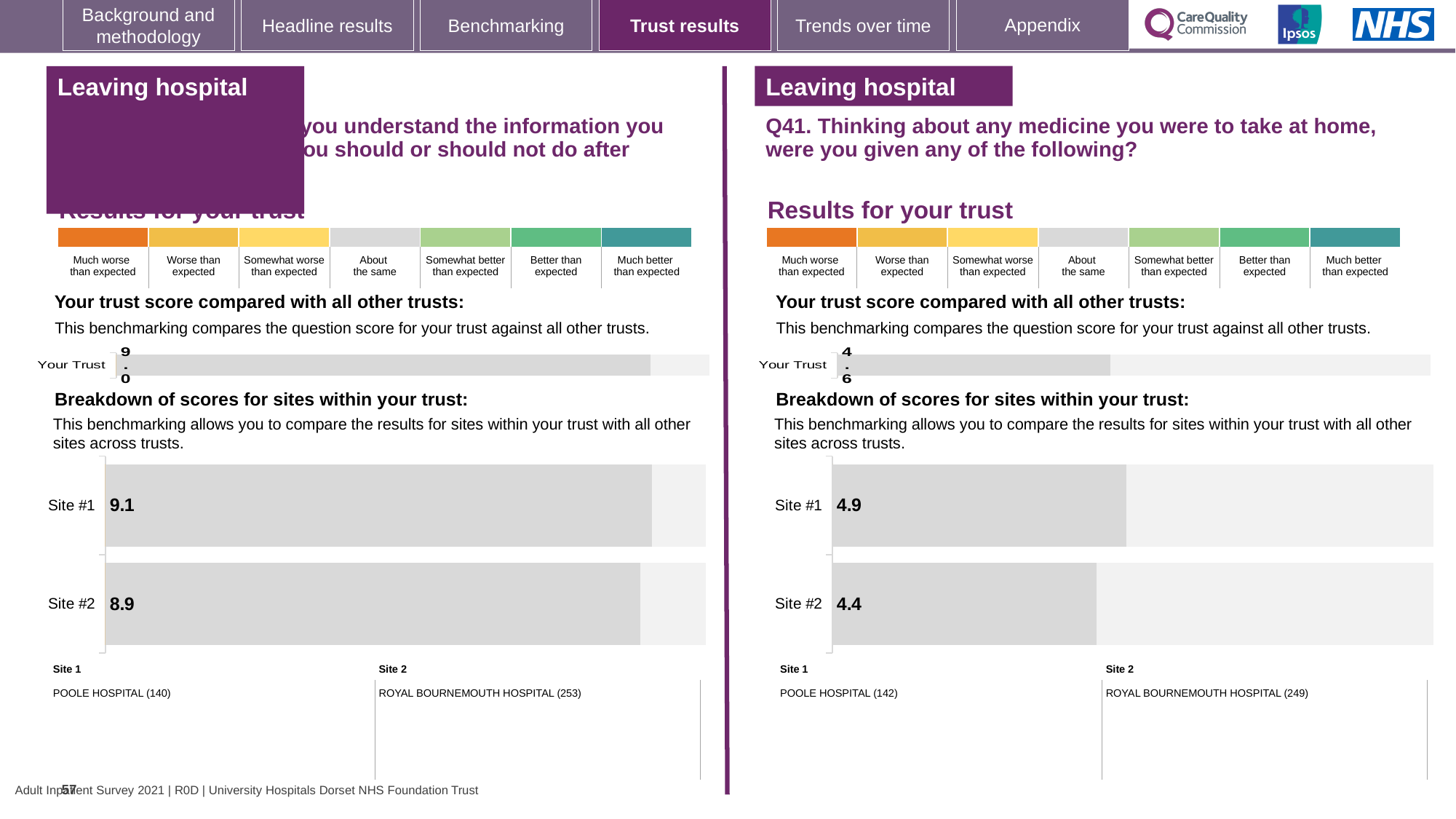
On the Q41 chart of site scores on the right, which site has the higher score? Site #1 On the left-hand chart of site scores, what is the difference between the Site #1 and Site #2 scores? 0.2 On the Q41 chart on the right, what is the 'Your Trust' score? 4.6 On the Q41 chart of site scores on the right, what is the difference between the Site #1 and Site #2 scores? 0.5 On the left-hand chart, what is the 'Your Trust' score? 9.0 On the left-hand chart of site scores, which site has the lower score? Site #2 On the Q41 chart of site scores on the right, what is the score for Site #2? 4.4 On the Q41 chart of site scores on the right, what is the score for Site #1? 4.9 On the left-hand chart of site scores, what is the score for Site #2? 8.9 How many sites are shown in the Q41 site breakdown chart on the right? 2 What type of chart is used for the breakdown of site scores on the left? Bar chart On the left-hand chart of site scores, what is the score for Site #1? 9.1